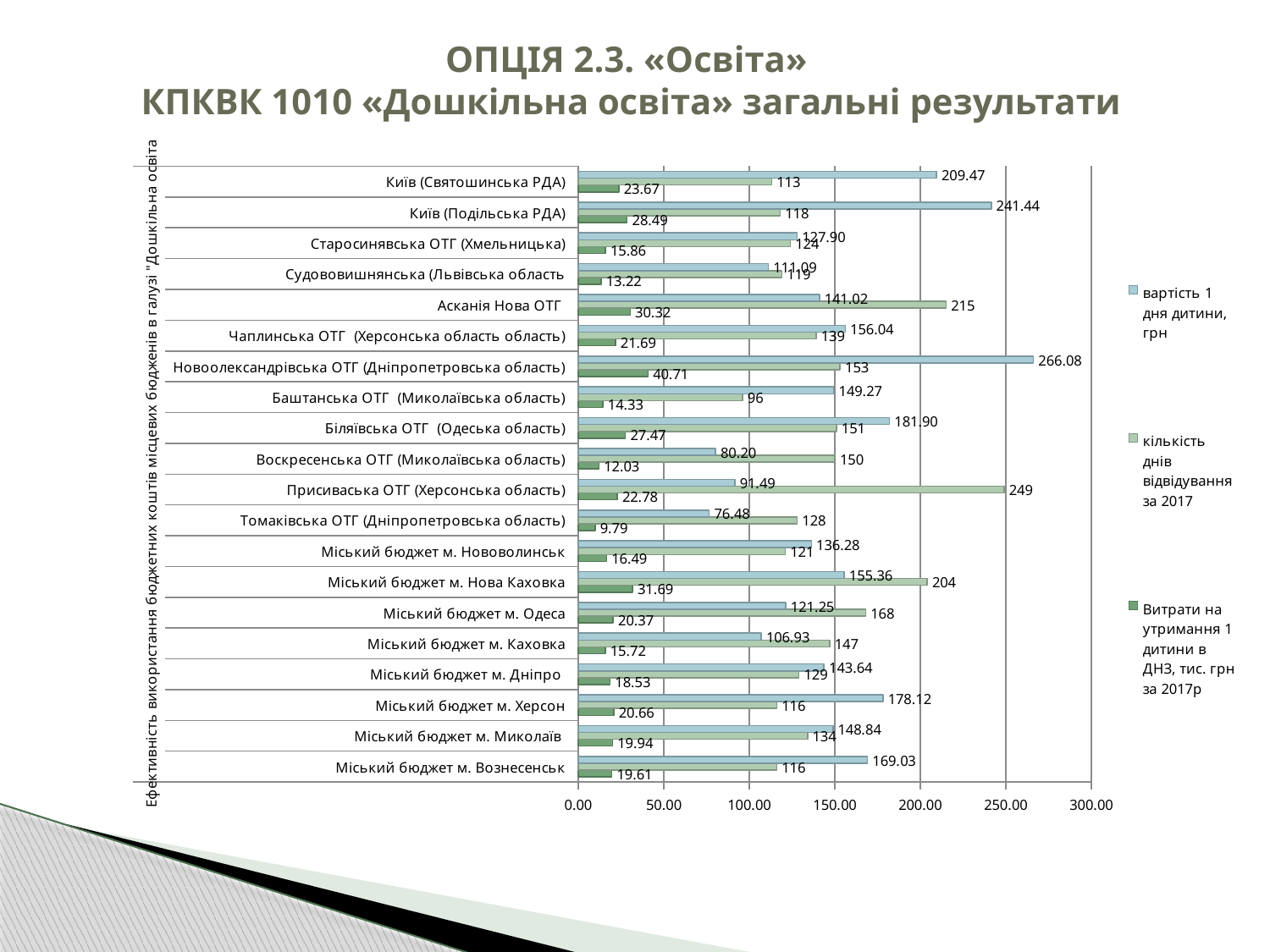
Is the 'вартість 1 дня дитини, грн' for Міський бюджет м. Херсон greater or less than 150.00? greater Which category has the lowest 'вартість 1 дня дитини, грн'? Томаківська ОТГ (Дніпропетровська область) What type of chart is shown on the slide? bar chart How many categories (budgets/communities) are plotted on the chart? 20 How many series does the legend list? 3 Which has a larger 'кількість днів відвідування за 2017': Асканія Нова ОТГ or Міський бюджет м. Одеса? Асканія Нова ОТГ What is the value of 'вартість 1 дня дитини, грн' for Новоолександрівська ОТГ (Дніпропетровська область)? 266.08 Which category has the lowest 'кількість днів відвідування за 2017'? Баштанська ОТГ (Миколаївська область) Which category has the highest 'вартість 1 дня дитини, грн'? Новоолександрівська ОТГ (Дніпропетровська область) What is the value of 'Витрати на утримання 1 дитини в ДНЗ, тис. грн за 2017р' for Міський бюджет м. Нова Каховка? 31.69 What is the value of 'кількість днів відвідування за 2017' for Присиваська ОТГ (Херсонська область)? 249 What is the difference in 'вартість 1 дня дитини, грн' between Київ (Подільська РДА) and Київ (Святошинська РДА)? 31.97